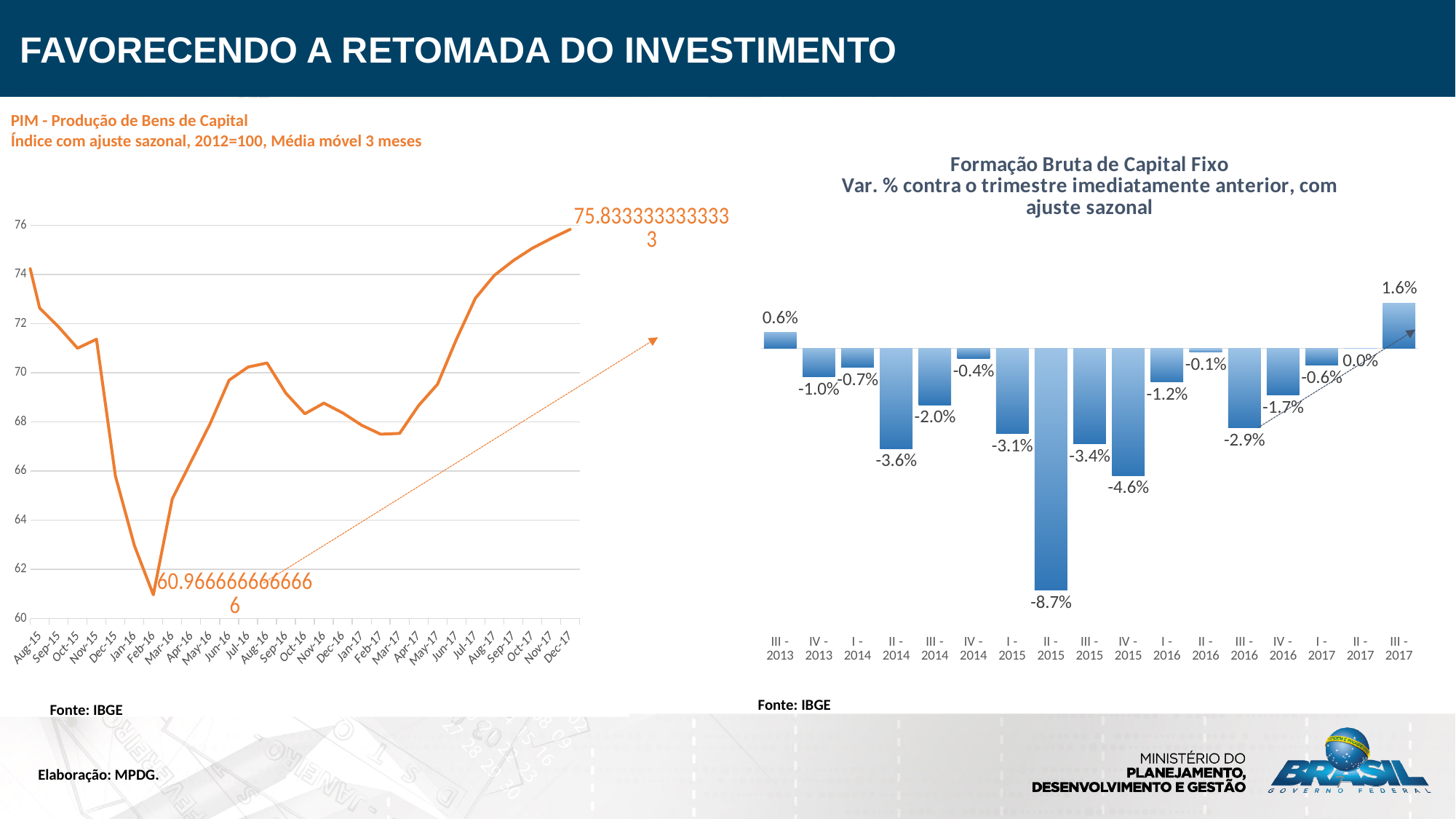
In the 'PIM - Produção de Bens de Capital' chart, what value is labelled for Feb-16? 60.9666666666666 In the 'PIM - Produção de Bens de Capital' chart, what value is labelled for Dec-17? 75.8333333333333 In the 'PIM - Produção de Bens de Capital' chart, is the value for Aug-15 greater or less than 72? greater In the 'Formação Bruta de Capital Fixo' chart, which quarter has the lowest value? II - 2015 In the 'Formação Bruta de Capital Fixo' chart, what is the difference between the values for III - 2017 and II - 2015? 10.3 percentage points What kind of chart is the 'PIM - Produção de Bens de Capital' chart on the left? line chart What kind of chart is the 'Formação Bruta de Capital Fixo' chart on the right? bar chart In the 'Formação Bruta de Capital Fixo' chart, what is the value for II - 2015? -8.7% In the 'Formação Bruta de Capital Fixo' chart, what is the value for III - 2017? 1.6% In the 'Formação Bruta de Capital Fixo' chart, which quarter has the highest value? III - 2017 How many quarters are plotted in the 'Formação Bruta de Capital Fixo' chart? 17 In the 'Formação Bruta de Capital Fixo' chart, which is lower, III - 2015 or IV - 2015? IV - 2015